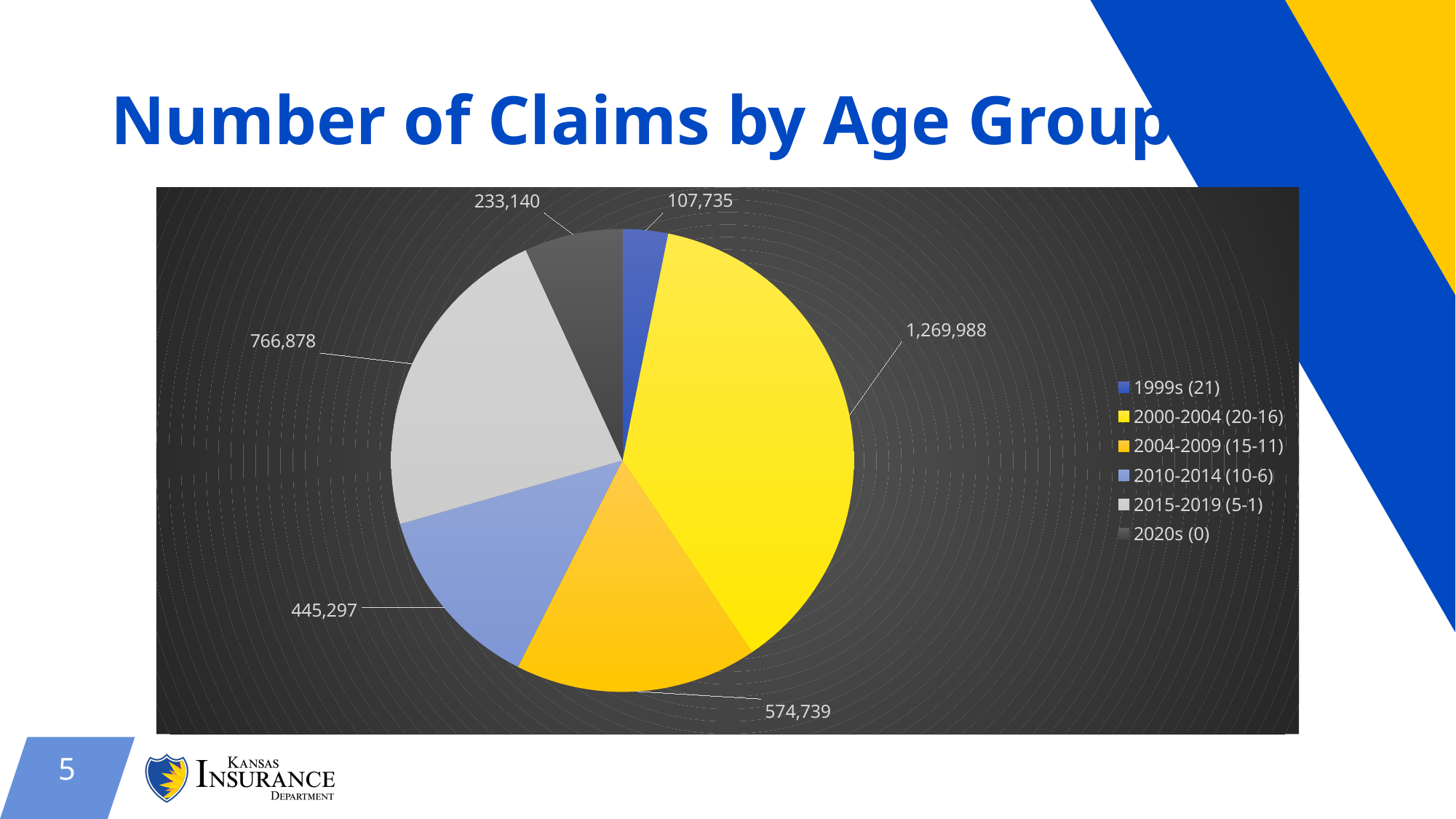
Which age group has the lowest number of claims? 1999s (21) Which age group has the highest number of claims? 2000-2004 (20-16) What is the number of claims for the 2000-2004 (20-16) age group? 1,269,988 What is the difference in claims between the 2020s (0) group and the 1999s (21) group? 125,405 Which has more claims, the 2004-2009 (15-11) group or the 2010-2014 (10-6) group? 2004-2009 (15-11) What type of chart is shown on the slide? Pie chart What is the number of claims for the 2015-2019 (5-1) age group? 766,878 What is the difference in claims between the 2000-2004 (20-16) group and the 2015-2019 (5-1) group? 503,110 What is the number of claims for the 1999s (21) age group? 107,735 What is the number of claims for the 2010-2014 (10-6) age group? 445,297 How many age groups are listed in the legend? 6 What is the title of the slide containing the chart? Number of Claims by Age Group